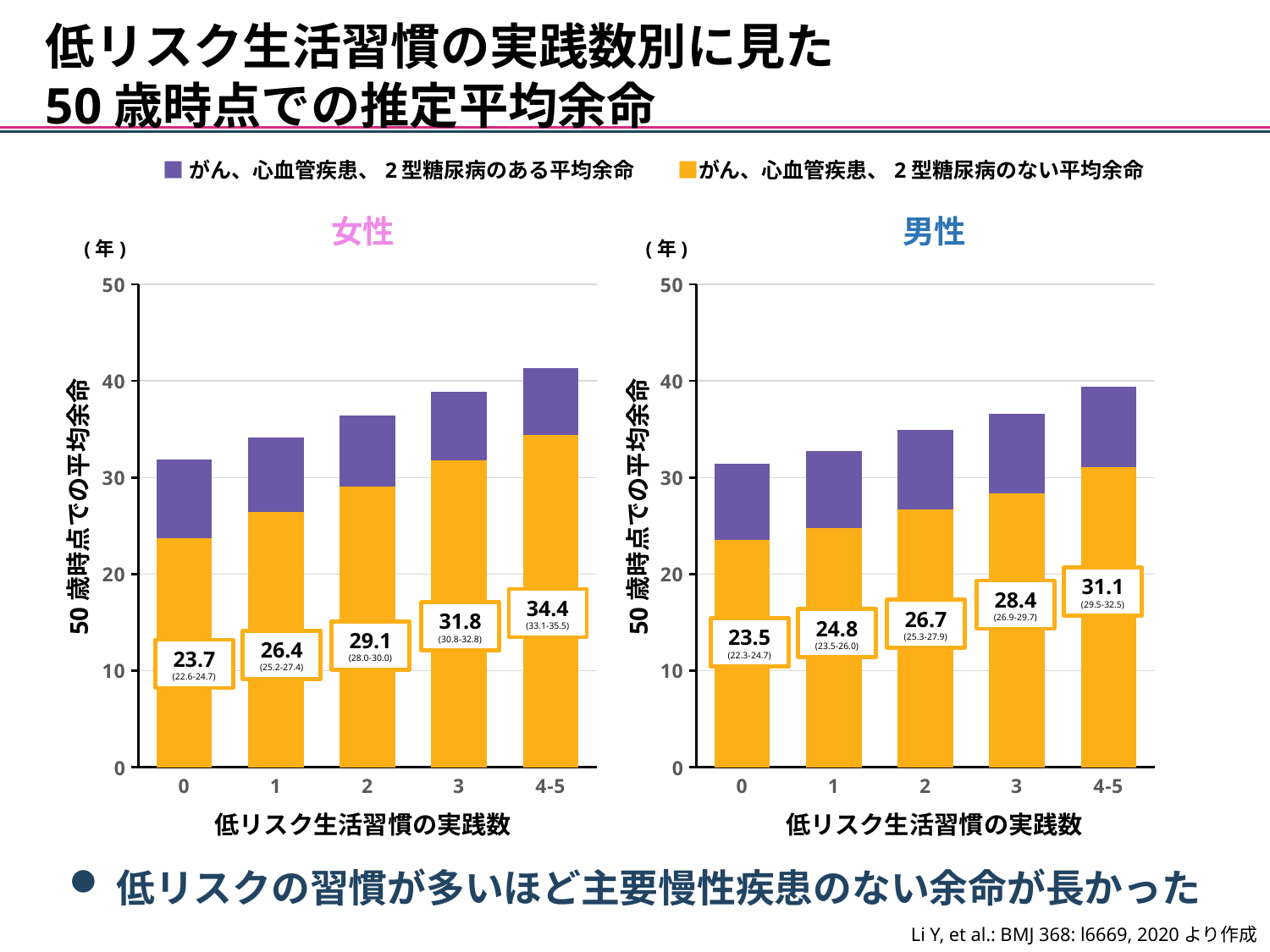
男性のグラフで、実践数2と実践数1の「がん、心血管疾患、2型糖尿病のない平均余命」の差はいくつですか？ 1.9 凡例にはいくつの系列が示されていますか？ 2 男性のグラフで、低リスク生活習慣の実践数が4-5の場合の「がん、心血管疾患、2型糖尿病のない平均余命」はいくつですか？ 31.1 女性のグラフで、「がん、心血管疾患、2型糖尿病のない平均余命」が最も長いのは実践数がいくつのときですか？ 4-5 女性のグラフで、実践数が2の場合の「がん、心血管疾患、2型糖尿病のない平均余命」はいくつですか？ 29.1 女性のグラフで、実践数4-5と実践数0の「がん、心血管疾患、2型糖尿病のない平均余命」の差はいくつですか？ 10.7 男性のグラフで、「がん、心血管疾患、2型糖尿病のない平均余命」が最も短いのは実践数がいくつのときですか？ 0 男性のグラフで、実践数が3の場合の「がん、心血管疾患、2型糖尿病のない平均余命」はいくつですか？ 28.4 女性のグラフで、低リスク生活習慣の実践数が0の場合の「がん、心血管疾患、2型糖尿病のない平均余命」はいくつですか？ 23.7 女性のグラフで、実践数が増えるにつれて「がん、心血管疾患、2型糖尿病のない平均余命」は増加していますか、減少していますか？ 増加 女性のグラフで、実践数4-5の棒全体の高さは40より大きいですか、小さいですか？ 大きい 実践数3の「がん、心血管疾患、2型糖尿病のない平均余命」は、女性と男性のどちらが長いですか？ 女性